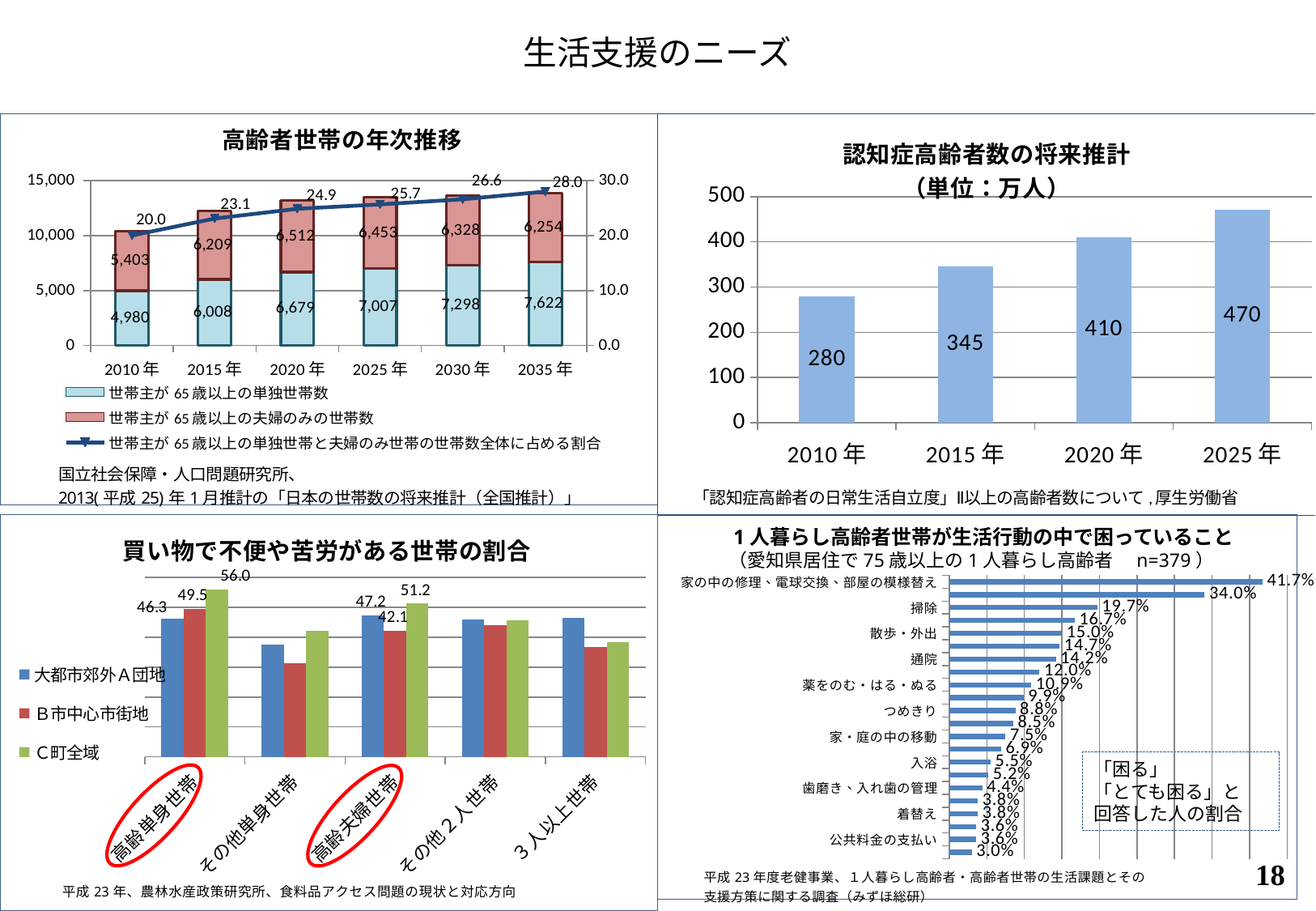
In the 1人暮らし高齢者世帯が生活行動の中で困っていること chart, what is the value for 家の中の修理、電球交換、部屋の模様替え? 41.7% In the 高齢者世帯の年次推移 chart, how many years are shown on the x axis? 6 In the 高齢者世帯の年次推移 chart, what is the value of the line series for 2030年? 26.6 In the 高齢者世帯の年次推移 chart, what is the total of the stacked bar for 2020年? 13,191 In the 認知症高齢者数の将来推計 chart, what is the difference between the values for 2020年 and 2010年? 130 In the 高齢者世帯の年次推移 chart, what is the value of 世帯主が65歳以上の夫婦のみの世帯数 for 2010年? 5,403 In the 認知症高齢者数の将来推計 chart, what is the value for 2025年? 470 In the 高齢者世帯の年次推移 chart, what is the value of 世帯主が65歳以上の単独世帯数 for 2035年? 7,622 In the 買い物で不便や苦労がある世帯の割合 chart, how many series does the legend list? 3 In the 買い物で不便や苦労がある世帯の割合 chart, what is the value for C町全域 in the 高齢単身世帯 category? 56.0 In the 認知症高齢者数の将来推計 chart, which year has the lowest value? 2010年 In the 認知症高齢者数の将来推計 chart, do the values rise or fall from 2010年 to 2025年? rise